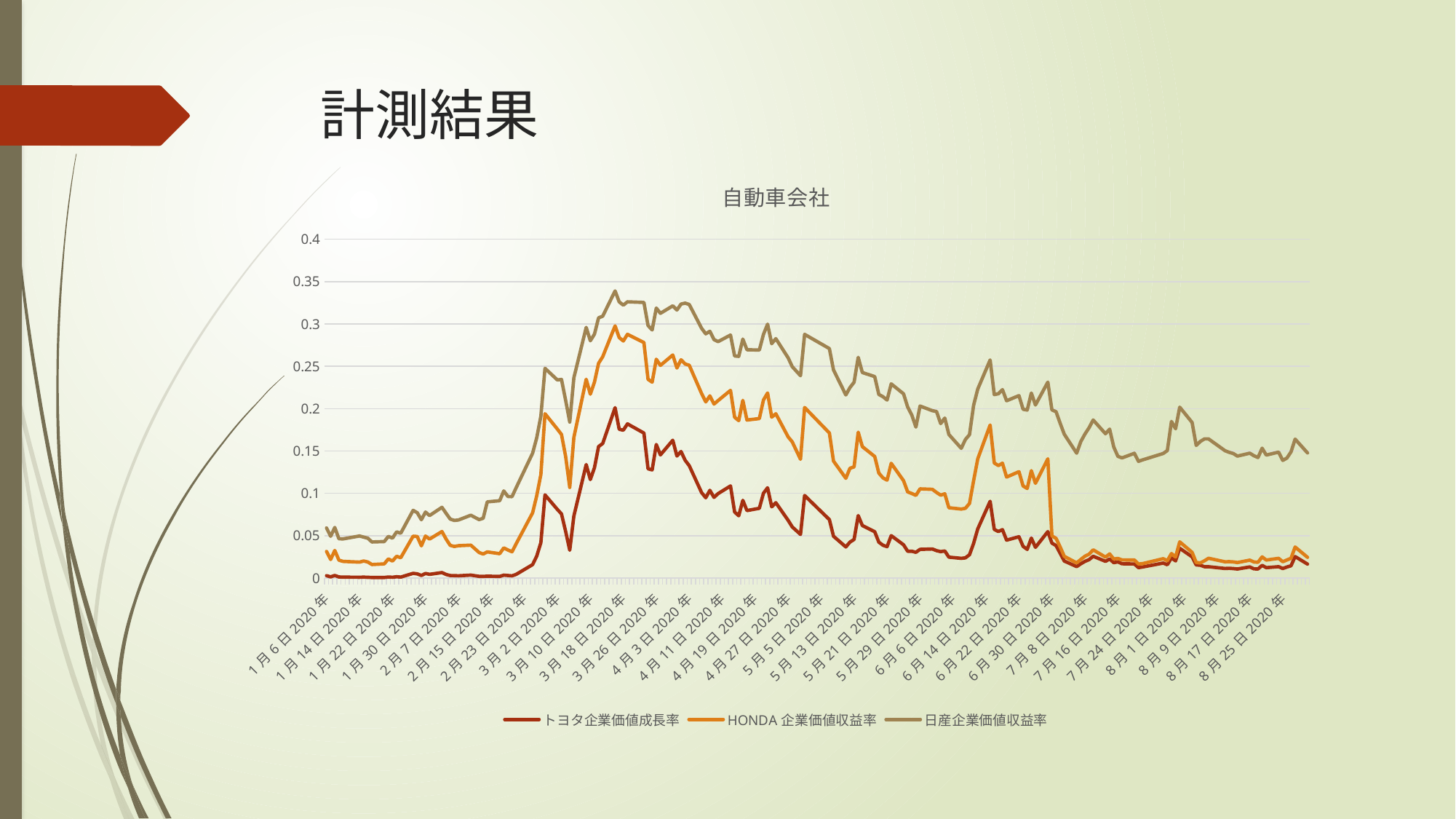
At 3月18日 2020年, which is higher: 日産企業価値収益率 or トヨタ企業価値成長率? 日産企業価値収益率 Is the value of HONDA 企業価値収益率 at 8月25日 2020年 greater or less than 0.05? less How many series does the legend list? 3 Which series stays lowest across the chart? トヨタ企業価値成長率 Does 日産企業価値収益率 generally rise or fall from 3月18日 to 8月25日 2020年? fall Which series is drawn in the darkest red line according to the legend? トヨタ企業価値成長率 Is the value of トヨタ企業価値成長率 at 1月6日 2020年 greater or less than 0.05? less What kind of chart is shown on the slide? line chart Is the peak value of トヨタ企業価値成長率 around 3月18日 greater or less than 0.15? greater What is the title of the chart? 自動車会社 Which series reaches the highest value on the chart? 日産企業価値収益率